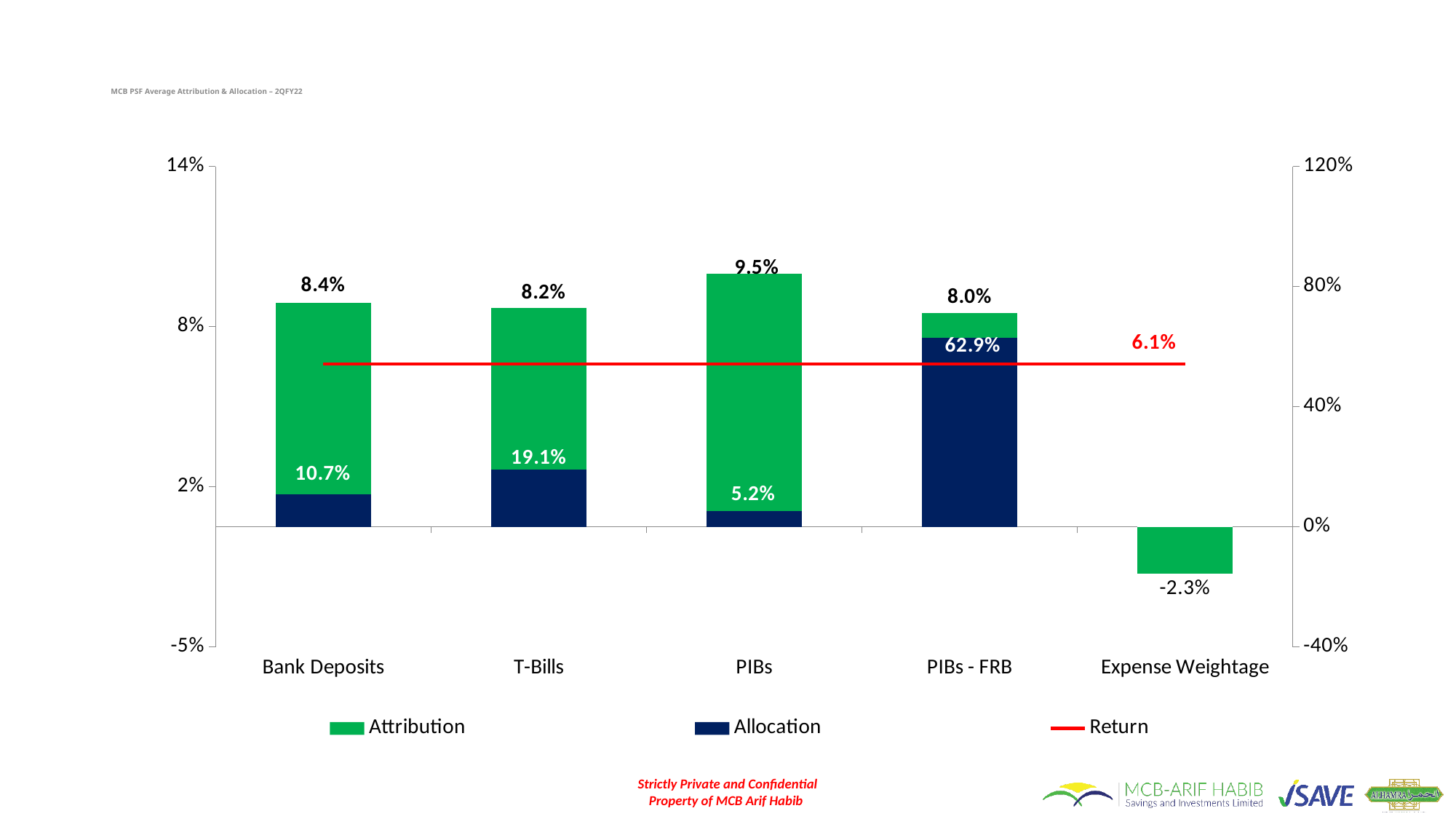
What is the Allocation value for PIBs - FRB? 62.9% What is the Attribution value for PIBs? 9.5% Which category has the highest Attribution value? PIBs What value is labelled on the Return line? 6.1% What is the Attribution value for Expense Weightage? -2.3% Which category has the lowest Allocation value? PIBs What is the Allocation value for T-Bills? 19.1% What is the difference between the Attribution values for PIBs and Bank Deposits? 1.1% What is the title of the chart? MCB PSF Average Attribution & Allocation – 2QFY22 How many series does the legend list? 3 How many categories are shown on the x axis? 5 Which has a larger Allocation value, Bank Deposits or T-Bills? T-Bills